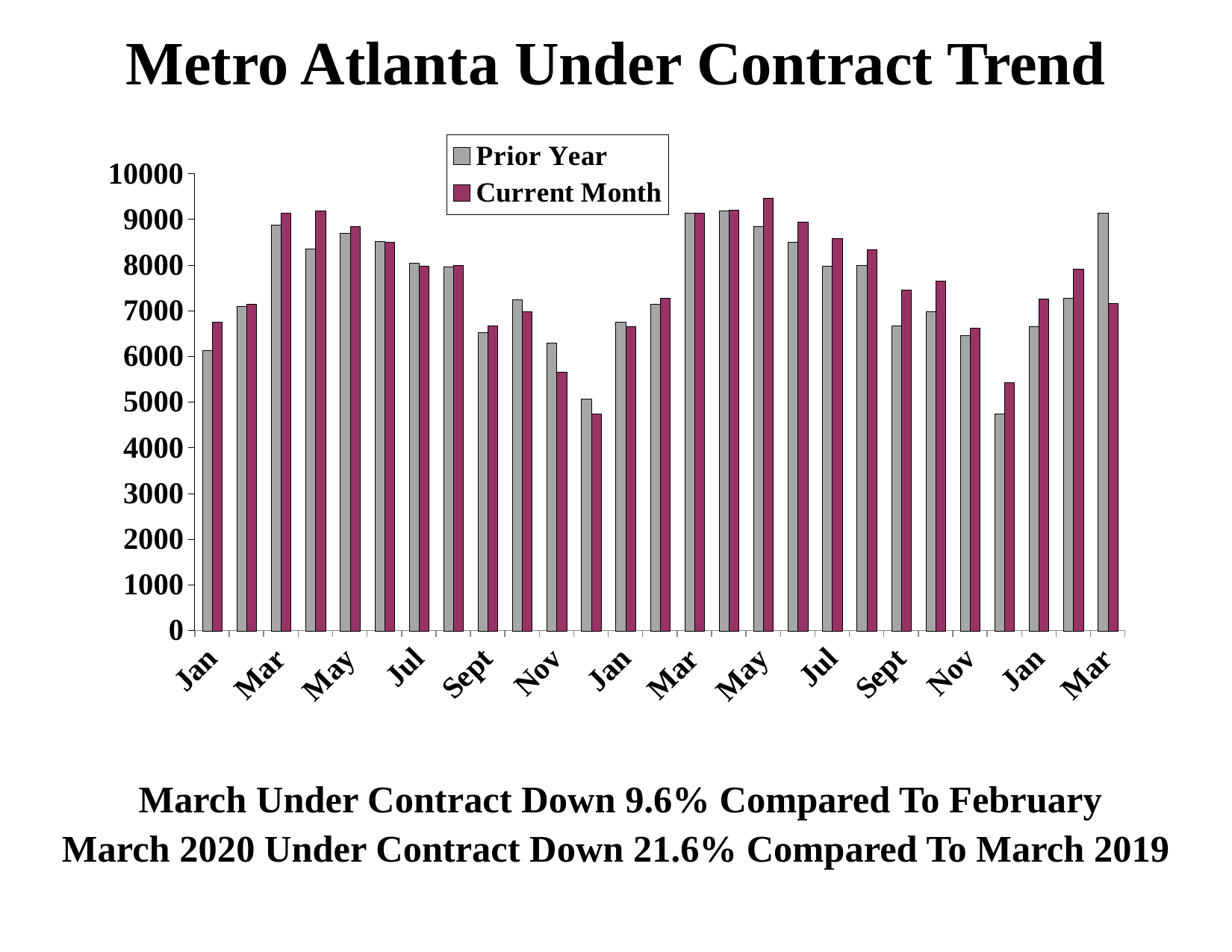
What kind of chart is shown on the slide? bar chart How many series does the legend list? 2 Which month has the lowest Current Month value? Dec (first year) What are the two series named in the legend? Prior Year and Current Month For the first Jan, which is larger: the Prior Year bar or the Current Month bar? Current Month Is the Prior Year value for the last Mar greater or less than 8000? greater Is the Current Month value for the first Jan greater or less than 6000? greater For the last Mar, which is larger: the Prior Year bar or the Current Month bar? Prior Year Do the Current Month values rise or fall from the first Jan to the first Mar? rise What is the title of the chart? Metro Atlanta Under Contract Trend Is the Current Month value for the last Mar greater or less than 8000? less Which month has the highest Current Month value? May (second year)